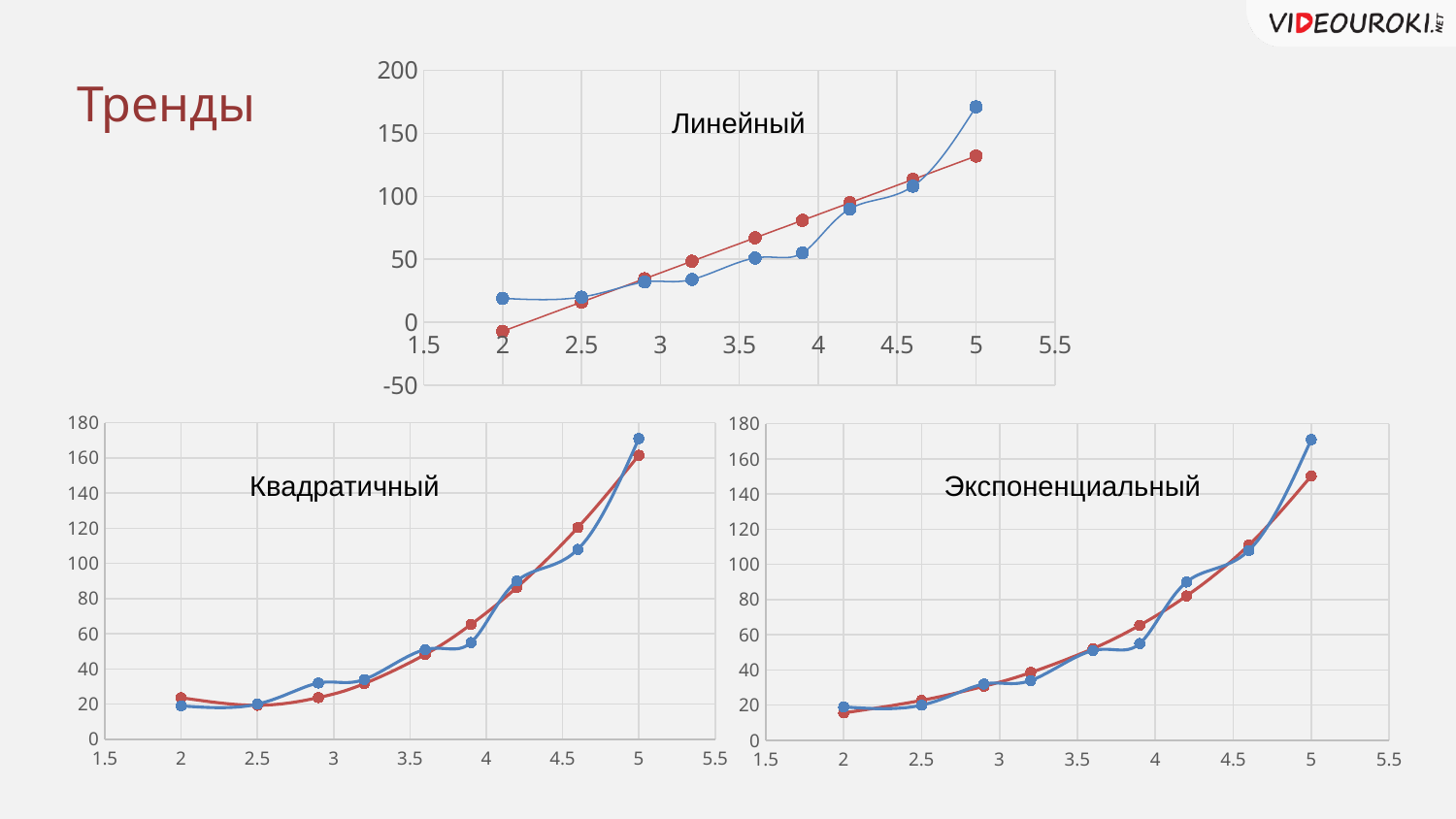
In the chart titled "Квадратичный", is the value of the blue series at x = 2 greater or less than 40? less What is the lowest value shown on the vertical axis of the chart titled "Линейный"? -50 In the chart titled "Квадратичный", is the value of the blue series at x = 5 greater or less than 160? greater In the chart titled "Линейный", how many data points does the blue series have? 9 What kind of chart is the chart titled "Линейный"? line chart In the chart titled "Экспоненциальный", at x = 5, which series has the higher value, the blue or the red? blue In the chart titled "Линейный", do the values of the blue series generally rise or fall as x increases? rise In the chart titled "Линейный", is the value of the red series at x = 2 greater or less than 0? less In the chart titled "Линейный", at x = 5, which series has the higher value, the blue or the red? blue How many charts are shown on the slide? 3